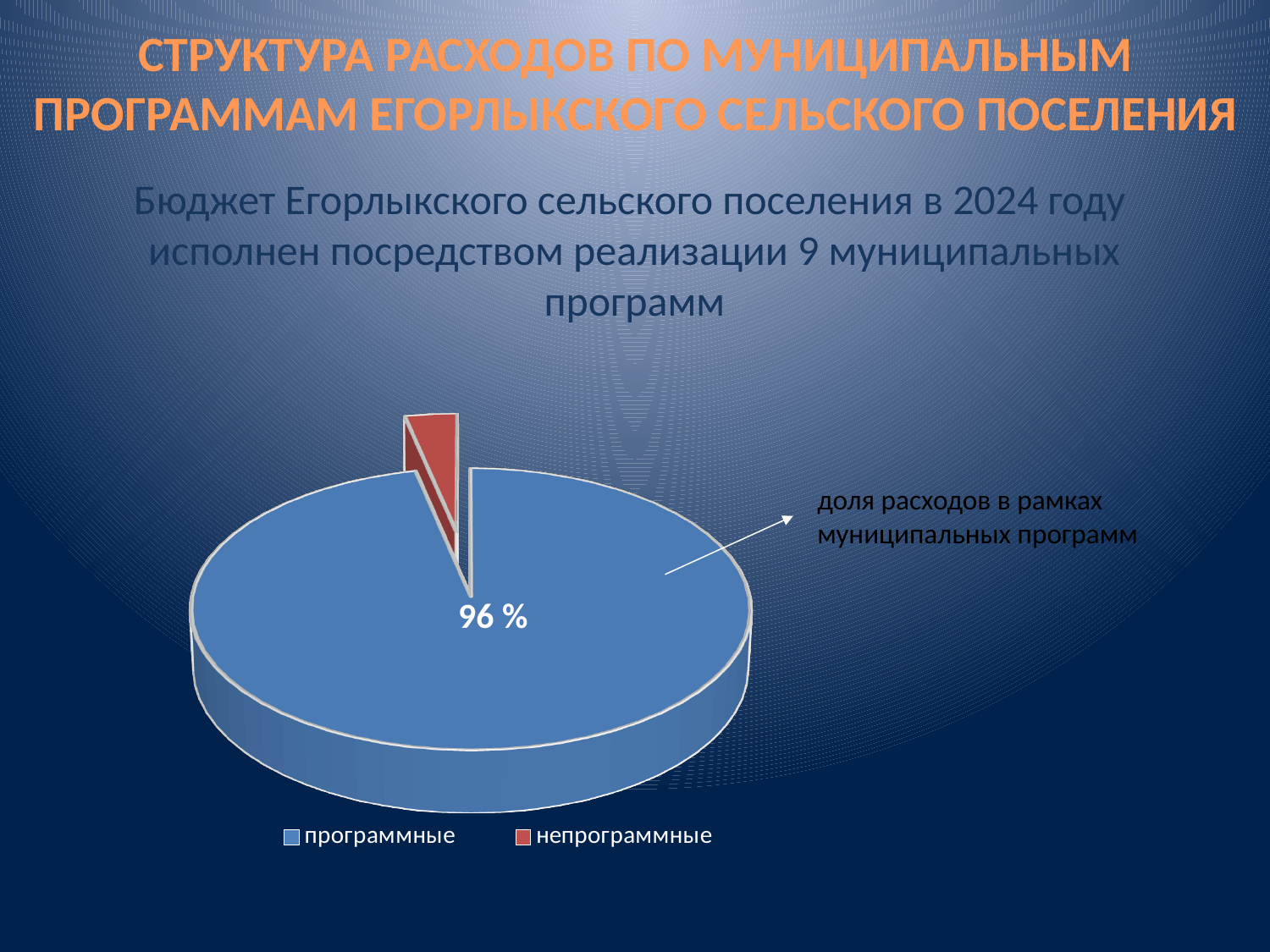
How many entries does the legend of the pie chart list? 2 Which is larger in the pie chart, "программные" or "непрограммные"? программные What value is shown for the "программные" slice of the pie chart? 96 % What colour is the "непрограммные" slice in the pie chart? red Which slice of the pie chart is the largest? программные What does the arrow annotation next to the pie chart say? доля расходов в рамках муниципальных программ What kind of chart is shown on the slide? pie chart How many slices does the pie chart have? 2 Which slice of the pie chart is the smallest? непрограммные